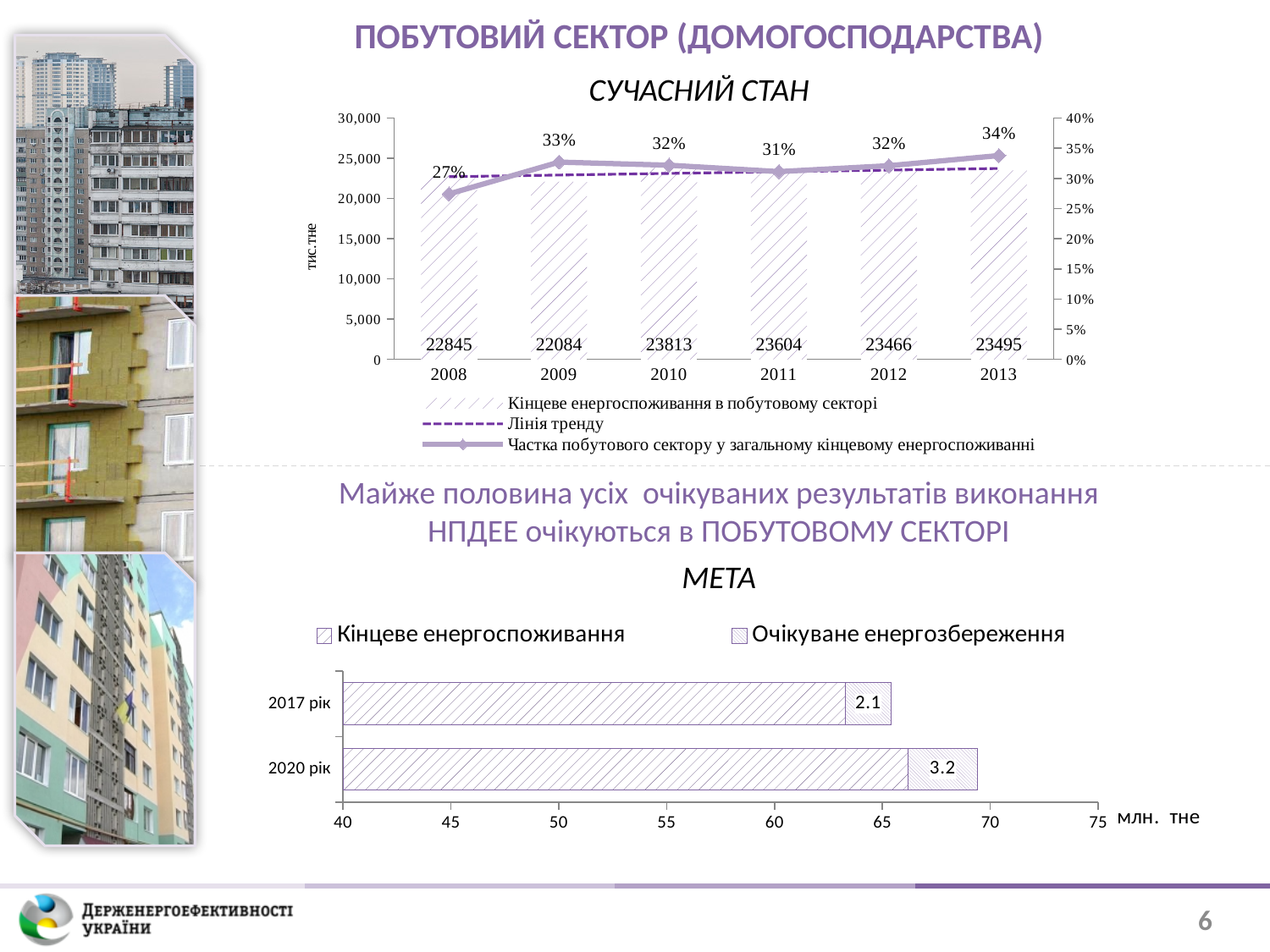
In the 'МЕТА' chart, what is the value of 'Очікуване енергозбереження' for 2020 рік? 3.2 What kind of chart is the 'МЕТА' chart? Bar chart In the 'СУЧАСНИЙ СТАН' chart, which year has the lowest final energy consumption in the household sector? 2009 In the 'СУЧАСНИЙ СТАН' chart, what is the value of 'Кінцеве енергоспоживання в побутовому секторі' for 2010? 23813 In the 'МЕТА' chart, is the expected energy saving larger for 2017 рік or for 2020 рік? 2020 рік In the 'СУЧАСНИЙ СТАН' chart, how many entries does the legend list? 3 In the 'СУЧАСНИЙ СТАН' chart, how many years are shown on the x axis? 6 In the 'СУЧАСНИЙ СТАН' chart, is the final energy consumption higher in 2008 or in 2012? 2012 In the 'СУЧАСНИЙ СТАН' chart, which year has the highest share of the household sector in total final energy consumption? 2013 In the 'СУЧАСНИЙ СТАН' chart, what is the difference between the final energy consumption in 2010 and in 2009? 1729 In the 'СУЧАСНИЙ СТАН' chart, what is the share of the household sector in total final energy consumption in 2008? 27% In the 'СУЧАСНИЙ СТАН' chart, which year has the highest final energy consumption in the household sector? 2010